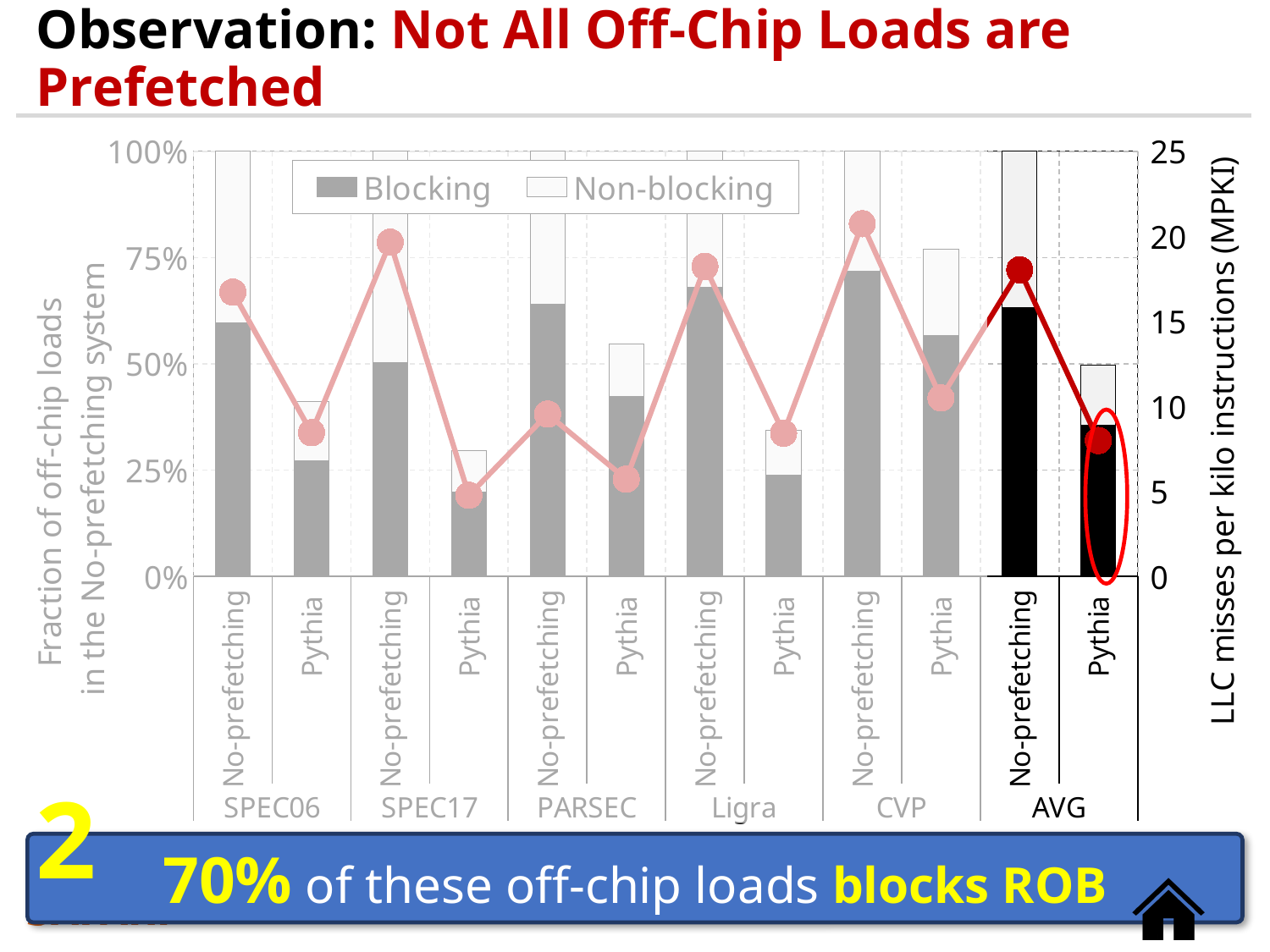
How many series does the legend list? 2 What are the two series named in the legend? Blocking and Non-blocking How many benchmark groups are shown along the x axis? 6 Is the LLC MPKI value for No-prefetching in AVG greater or less than 15? greater Is the Blocking value for Pythia in AVG greater or less than 50%? less What kind of chart is shown on the slide? Stacked bar chart with a line overlay Which bar has the lowest Blocking fraction? Pythia in SPEC17 How many bars are plotted in total? 12 Is the LLC MPKI value for Pythia in AVG greater or less than 10? less What is the total height of the No-prefetching stacked bar for SPEC06? 100%